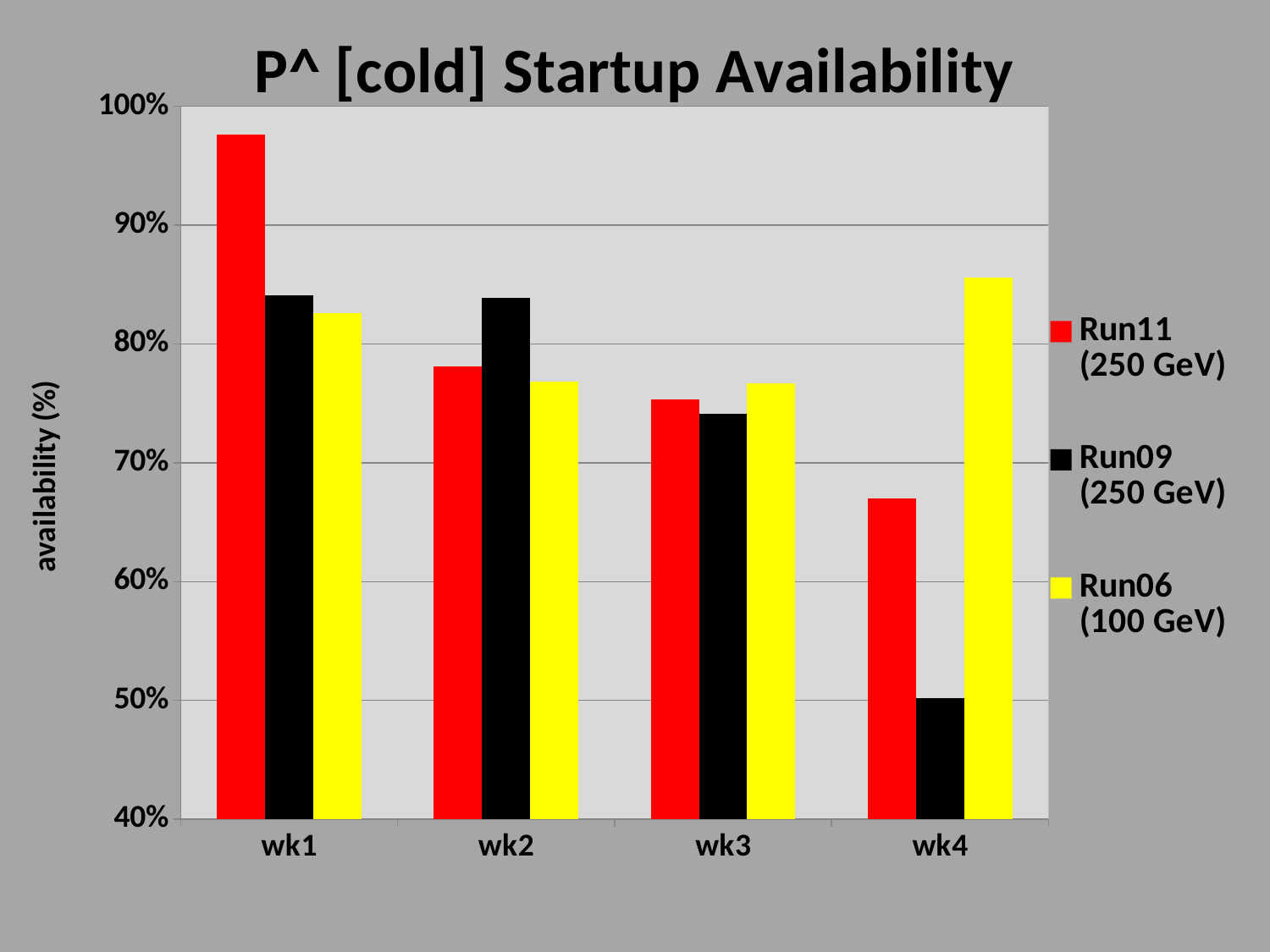
How many week categories are shown on the x axis? 4 Is the Run11 (250 GeV) availability for wk1 greater or less than 90%? greater In which week is the Run11 (250 GeV) availability highest? wk1 How many series does the legend list? 3 In which week is the Run06 (100 GeV) availability highest? wk4 What kind of chart is shown on the slide? bar chart In wk4, which series has the higher availability, Run06 (100 GeV) or Run11 (250 GeV)? Run06 (100 GeV) Does the Run11 (250 GeV) availability rise or fall from wk1 to wk4? fall What is the label on the vertical axis? availability (%) In which week is the Run09 (250 GeV) availability lowest? wk4 In wk2, which series has the higher availability, Run09 (250 GeV) or Run11 (250 GeV)? Run09 (250 GeV) Is the Run09 (250 GeV) availability for wk4 greater or less than 60%? less